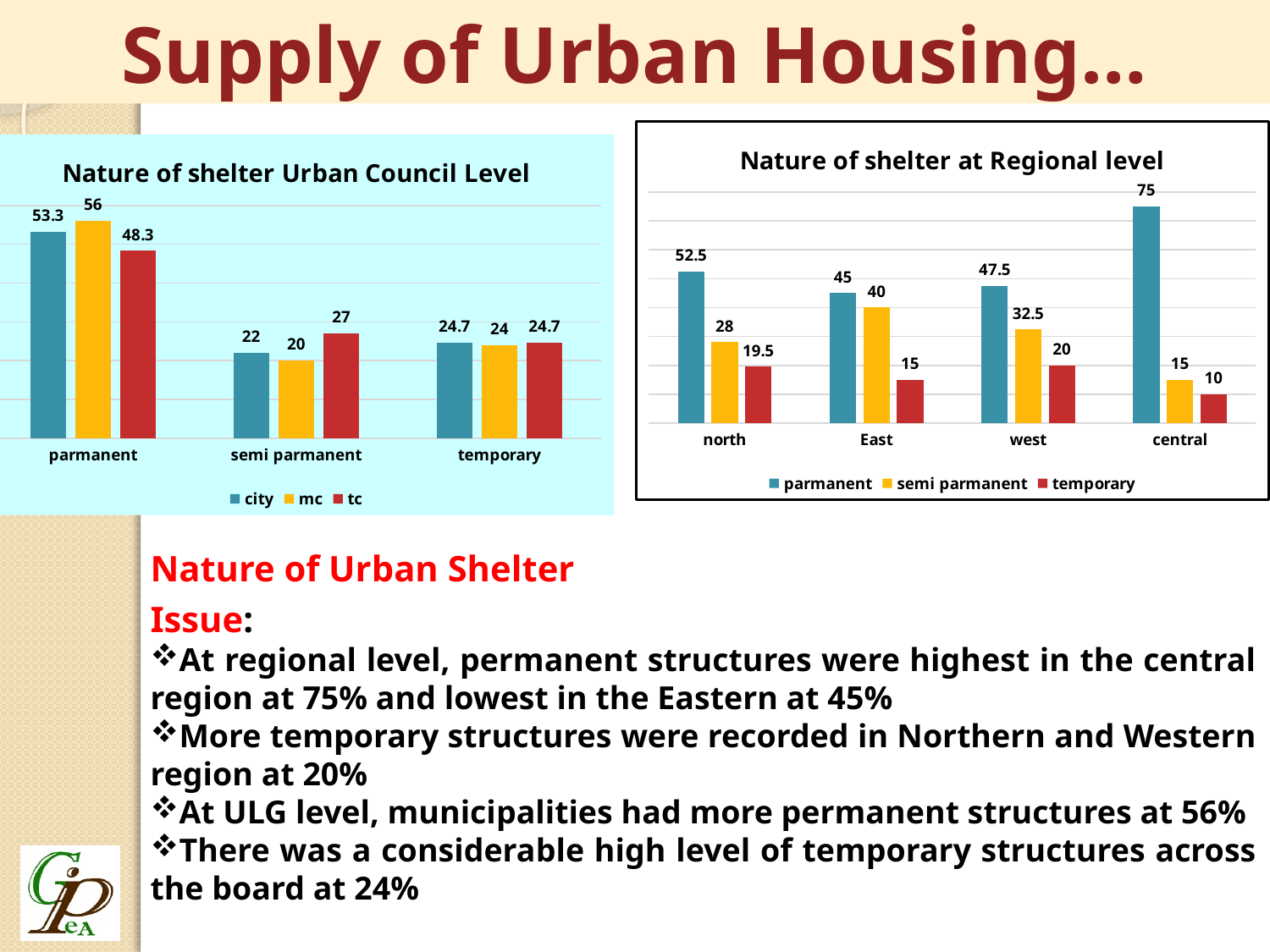
In the 'Nature of shelter at Regional level' chart, which region has the lowest parmanent value? East In the 'Nature of shelter at Regional level' chart, what is the difference between the parmanent values for central and East? 30 In the 'Nature of shelter Urban Council Level' chart, what is the difference between the city and tc values for parmanent? 5 In the 'Nature of shelter Urban Council Level' chart, how many series does the legend list? 3 What type of chart is the 'Nature of shelter at Regional level' chart? Bar chart In the 'Nature of shelter Urban Council Level' chart, which series has the highest value in the parmanent category? mc In the 'Nature of shelter at Regional level' chart, how many regions are shown on the x axis? 4 In the 'Nature of shelter at Regional level' chart, what is the temporary value for north? 19.5 In the 'Nature of shelter Urban Council Level' chart, what is the value for mc in the parmanent category? 56 In the 'Nature of shelter Urban Council Level' chart, what is the value for tc in the semi parmanent category? 27 In the 'Nature of shelter at Regional level' chart, what is the parmanent value for central? 75 In the 'Nature of shelter at Regional level' chart, which is larger: the semi parmanent value for East or for west? East